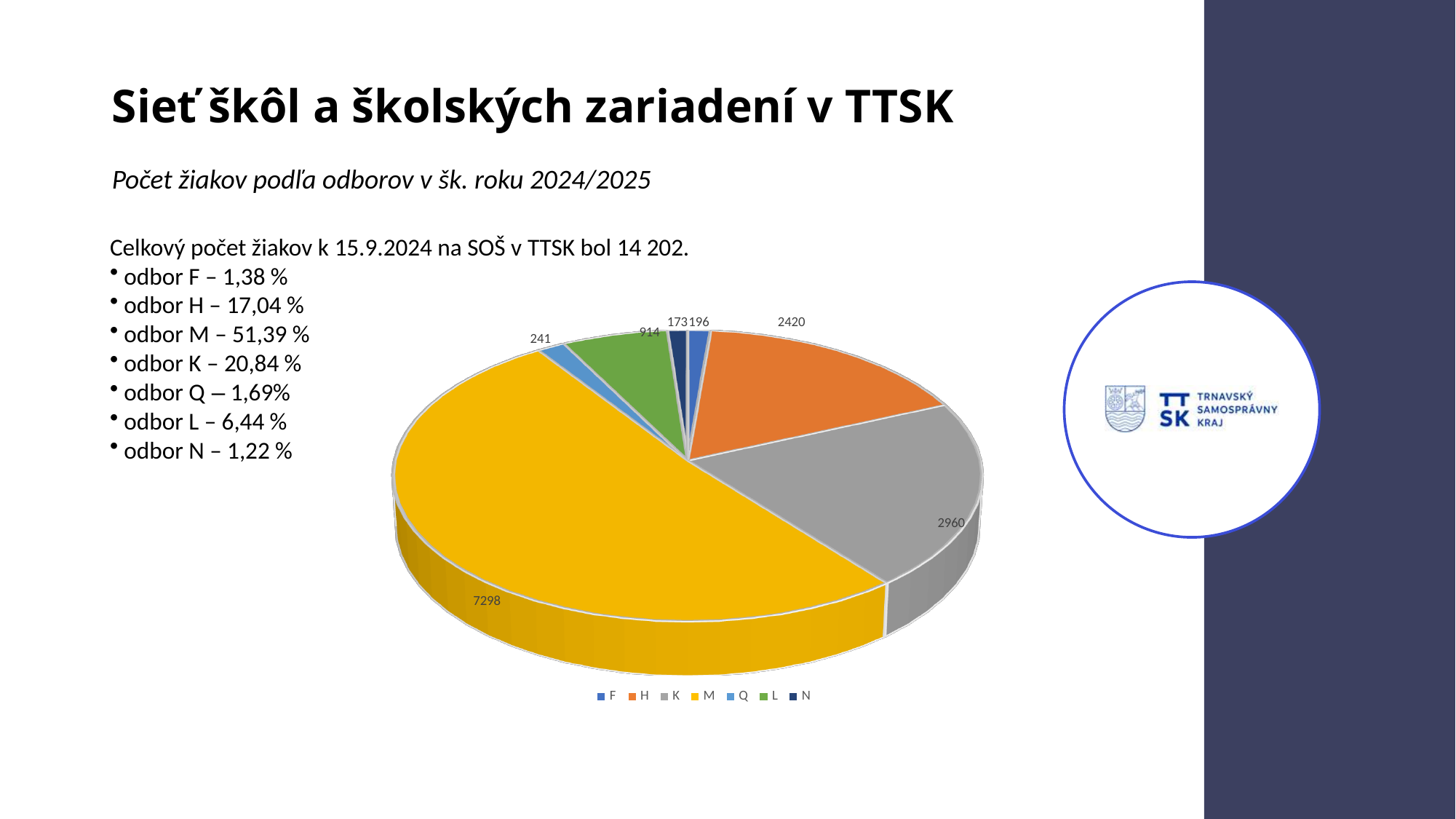
Which category has the smallest slice in the pie chart? N Which is larger in the pie chart, the value for H or the value for K? K What is the value for category Q in the pie chart? 241 What is the value for category K in the pie chart? 2960 What is the value for category H in the pie chart? 2420 What is the difference between the values for K and H in the pie chart? 540 How many categories does the pie chart show? 7 What type of chart is shown on the slide? pie chart Which category has the largest slice in the pie chart? M What is the value for category M in the pie chart? 7298 What is the value for category L in the pie chart? 914 What share of the pie does category M represent, as stated on the slide? 51,39 %